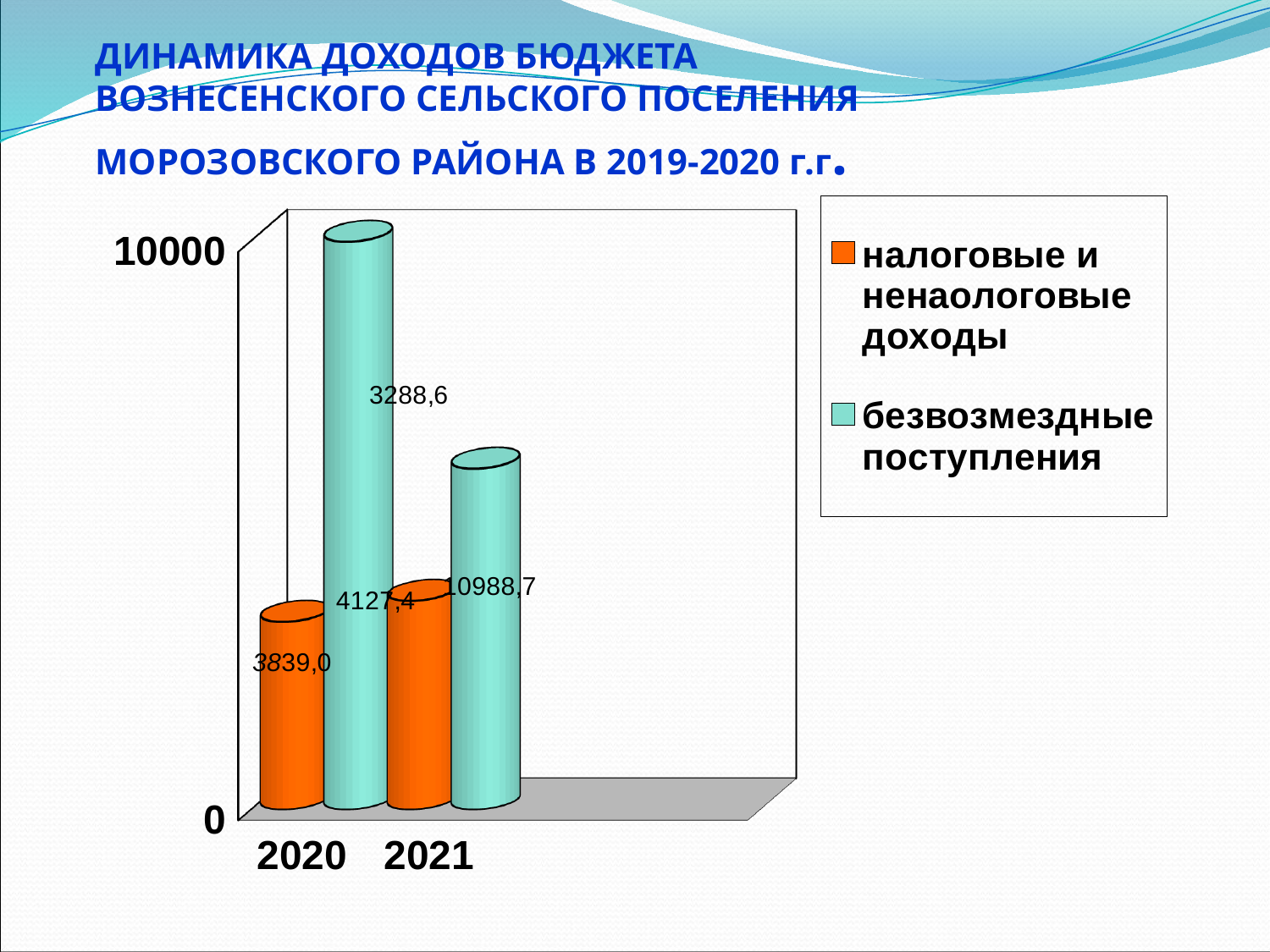
How many years (categories) are shown on the x axis of the chart? 2 How many series does the chart legend list? 2 Which series is shown in orange in the legend? налоговые и ненаологовые доходы What is the highest value labelled on the vertical axis of the chart? 10000 What is the value of налоговые и неналоговые доходы for 2021? 4127,4 In which year is the tallest bar on the chart? 2020 Which year has the higher value for налоговые и неналоговые доходы, 2020 or 2021? 2021 What kind of chart is shown on the slide? bar chart What is the value of налоговые и неналоговые доходы for 2020? 3839,0 What is the difference between налоговые и неналоговые доходы in 2021 and in 2020? 288,4 Is the bar for безвозмездные поступления in 2021 greater or less than 10000? less